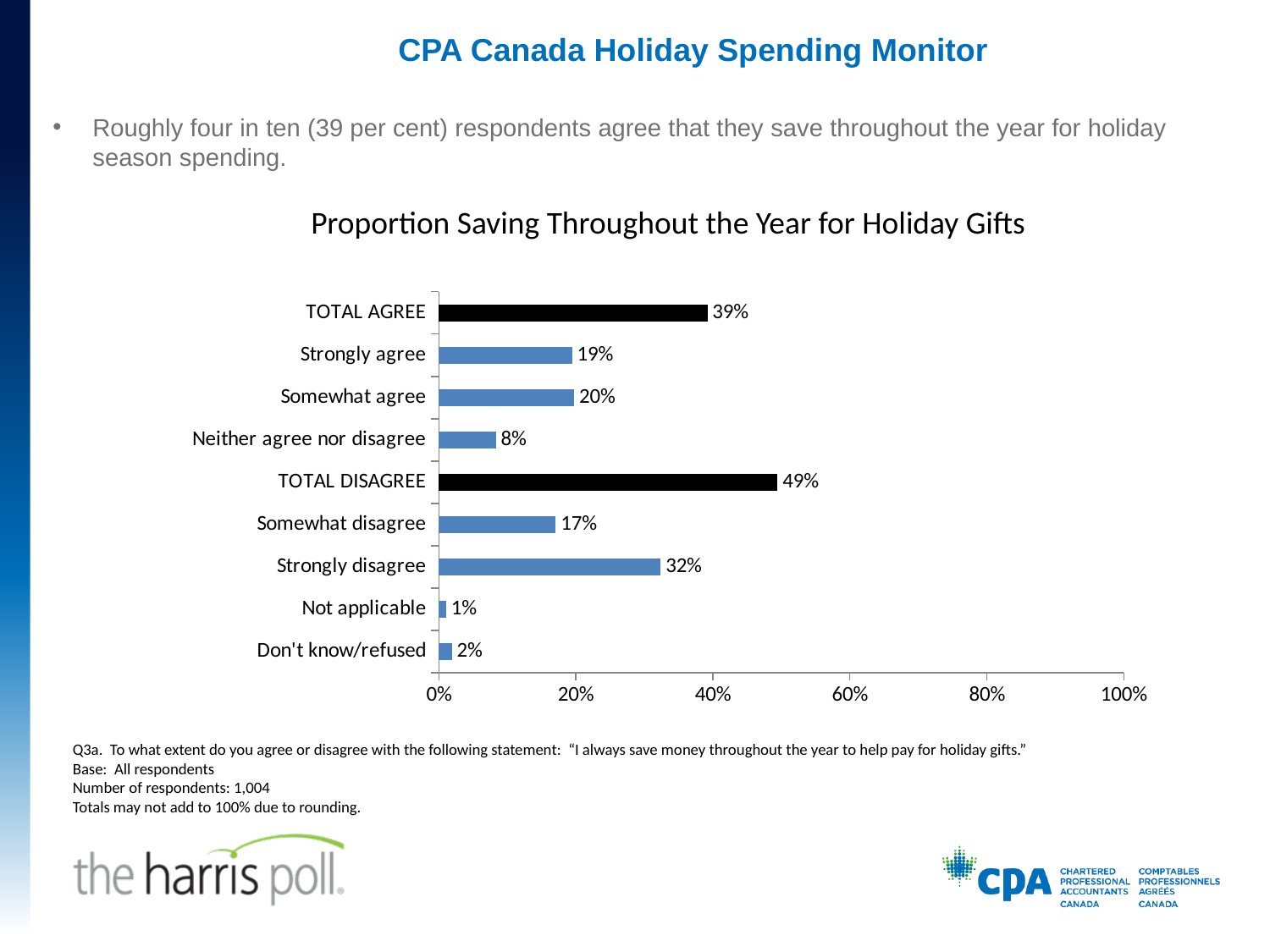
Is the value for TOTAL DISAGREE greater or less than 40%? greater What is the value for Strongly disagree? 32% What is the value for Neither agree nor disagree? 8% Which category has the lowest value? Not applicable What is the value for TOTAL AGREE? 39% What is the title of the chart? Proportion Saving Throughout the Year for Holiday Gifts How many categories are shown on the chart? 9 Which is larger, Strongly disagree or Somewhat disagree? Strongly disagree What kind of chart is shown? Bar chart Which category has the highest value? TOTAL DISAGREE What is the difference between TOTAL DISAGREE and TOTAL AGREE? 10% What is the difference between Somewhat agree and Strongly agree? 1%